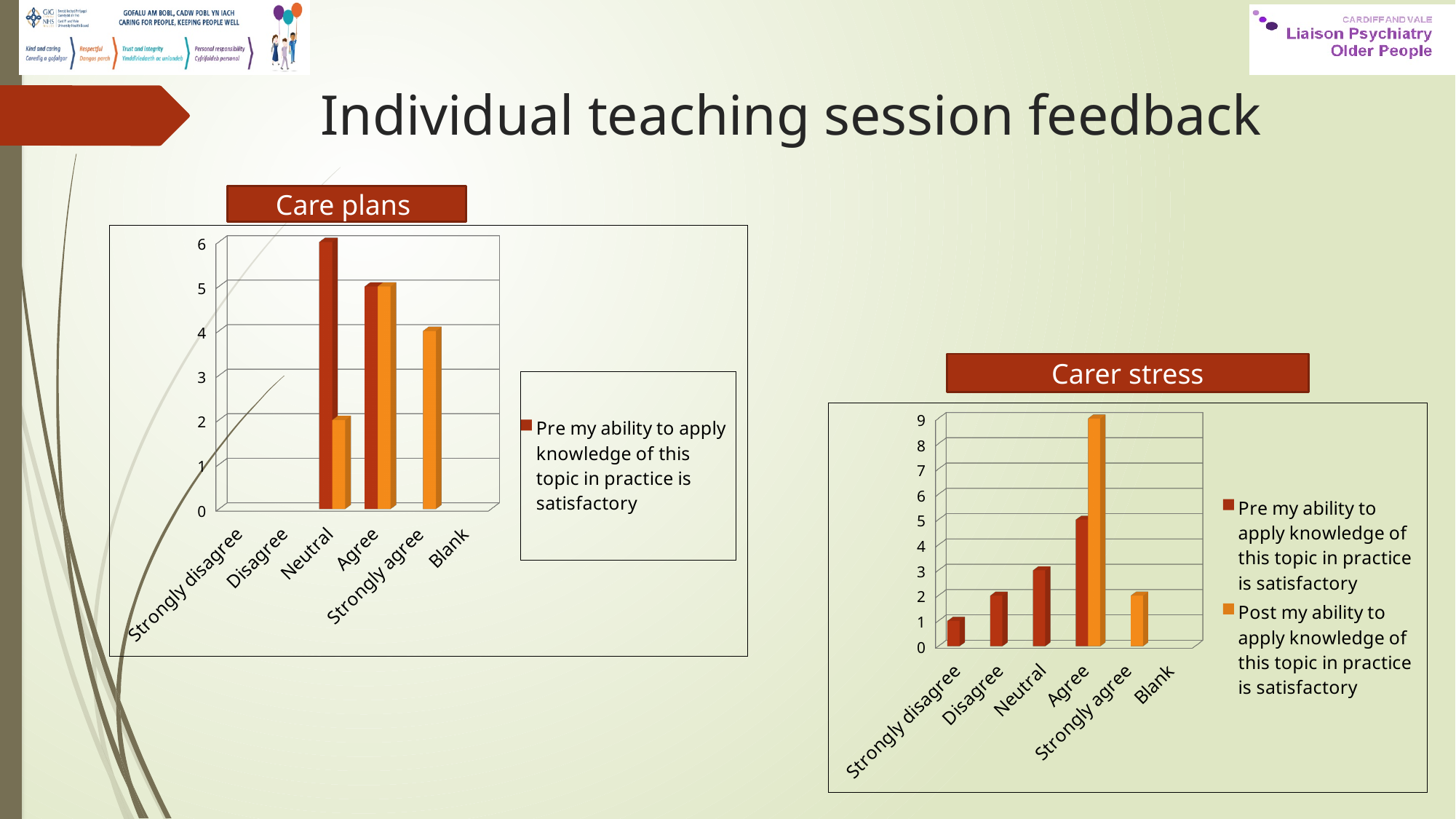
In the Carer stress chart, which category has the lowest Pre value? Strongly disagree In the Carer stress chart, do the Pre values rise or fall from Strongly disagree to Agree? rise In the Care plans chart, what is the difference between the Pre and Post values for Neutral? 4 What kind of chart is the Care plans chart? bar chart How many series does the legend of the Carer stress chart list? 2 In the Carer stress chart, what is the Post value for Agree? 9 In the Carer stress chart, what is the Pre value for Neutral? 3 In the Carer stress chart, is the Pre value for Agree larger or smaller than the Post value for Agree? smaller In the Care plans chart, what is the Pre value for Neutral? 6 How many categories are shown on the x axis of the Care plans chart? 6 In the Care plans chart, what is the Post value for Strongly agree? 4 In the Care plans chart, which category has the highest Pre value? Neutral